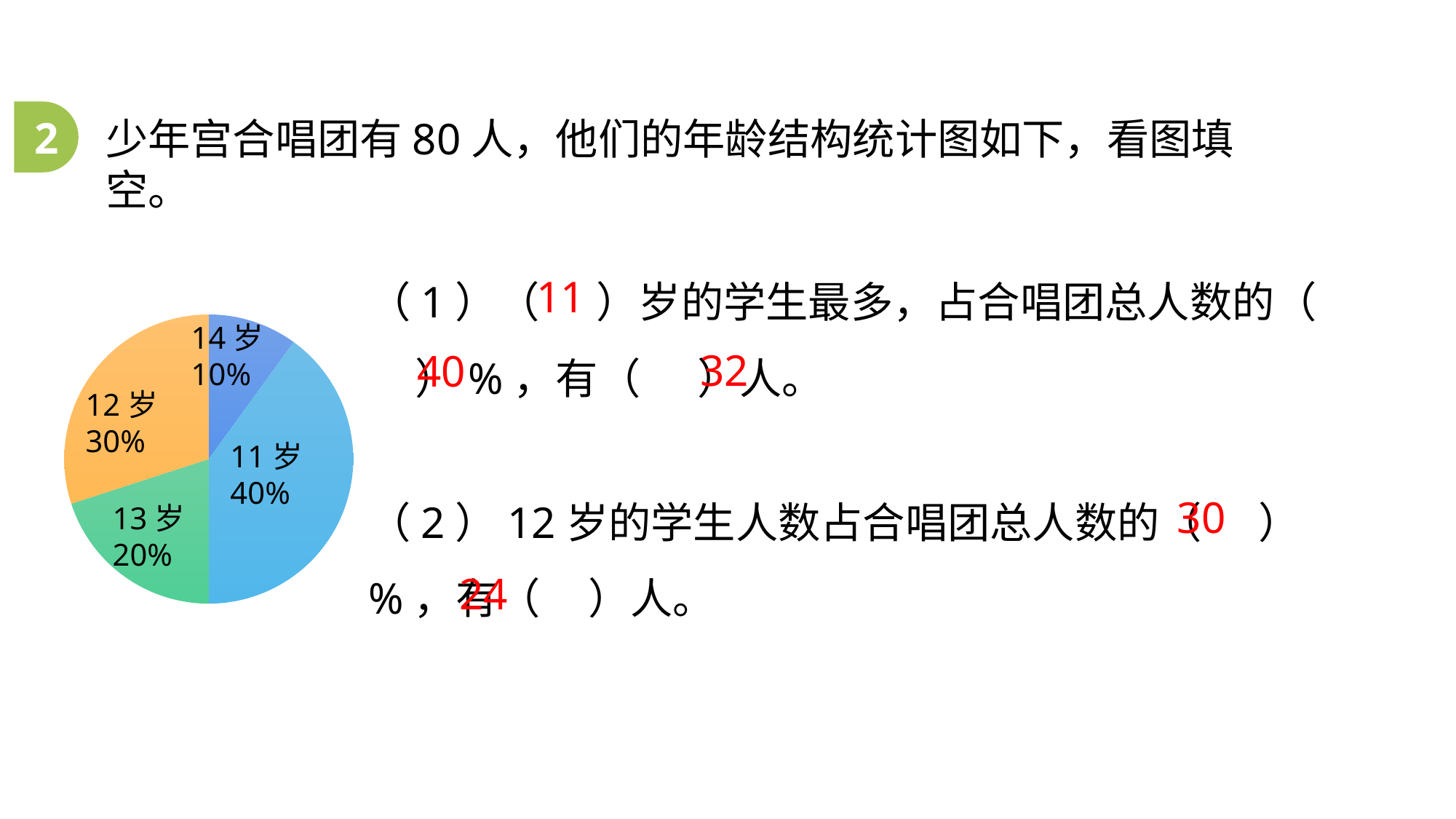
How many age groups (slices) does the pie chart show? 4 What colour is the 11 岁 slice of the pie chart? blue Which slice is larger, 12 岁 or 14 岁? 12 岁 What percentage of the choir is 14 岁 (14 years old)? 10% What percentage of the choir is 12 岁 (12 years old)? 30% What is the combined share of the 12 岁 and 13 岁 slices? 50% Which age group has the smallest share of the pie? 14 岁 What is the difference in percentage points between the 11 岁 slice and the 13 岁 slice? 20% What type of chart is shown on the slide? pie chart Which age group has the largest share of the pie? 11 岁 What percentage of the choir is 13 岁 (13 years old)? 20% What percentage of the choir is 11 岁 (11 years old)? 40%